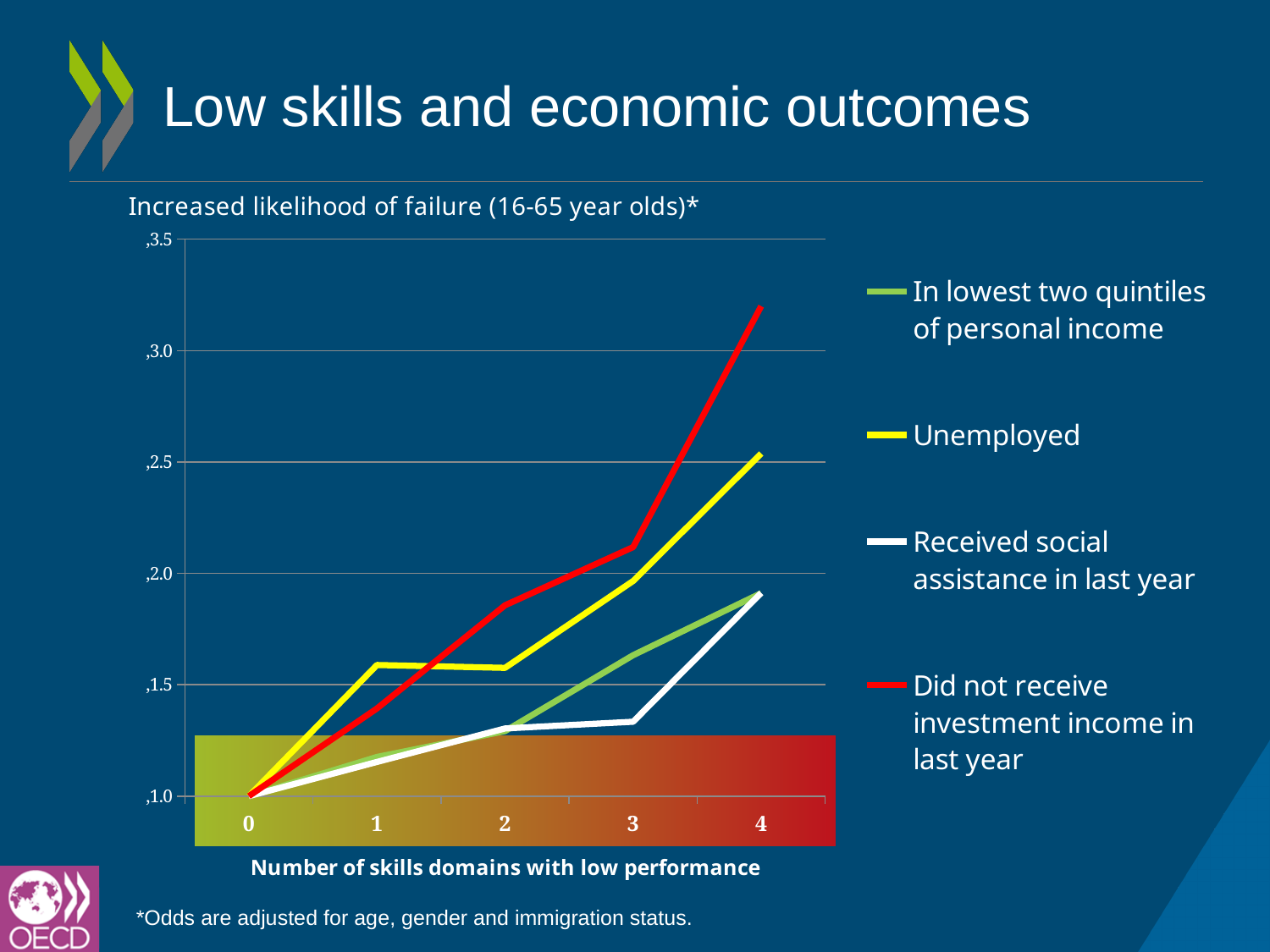
What is the label of the x axis? Number of skills domains with low performance Is the value for 'Unemployed' at 4 skills domains greater or less than 2.0? greater Which series has the highest value at 4 skills domains with low performance? Did not receive investment income in last year At 4 skills domains with low performance, which is larger: 'Unemployed' or 'Did not receive investment income in last year'? Did not receive investment income in last year Do the values for 'Unemployed' rise or fall as the number of skills domains with low performance increases from 0 to 4? rise Is the value for 'Did not receive investment income in last year' at 2 skills domains greater or less than 1.5? greater Which series has the lowest value at 3 skills domains with low performance? Received social assistance in last year How many points along the x axis (number of skills domains with low performance) are plotted? 5 How many series does the legend list? 4 What kind of chart is shown on the slide? line chart Is the value for 'Received social assistance in last year' at 3 skills domains greater or less than 1.5? less